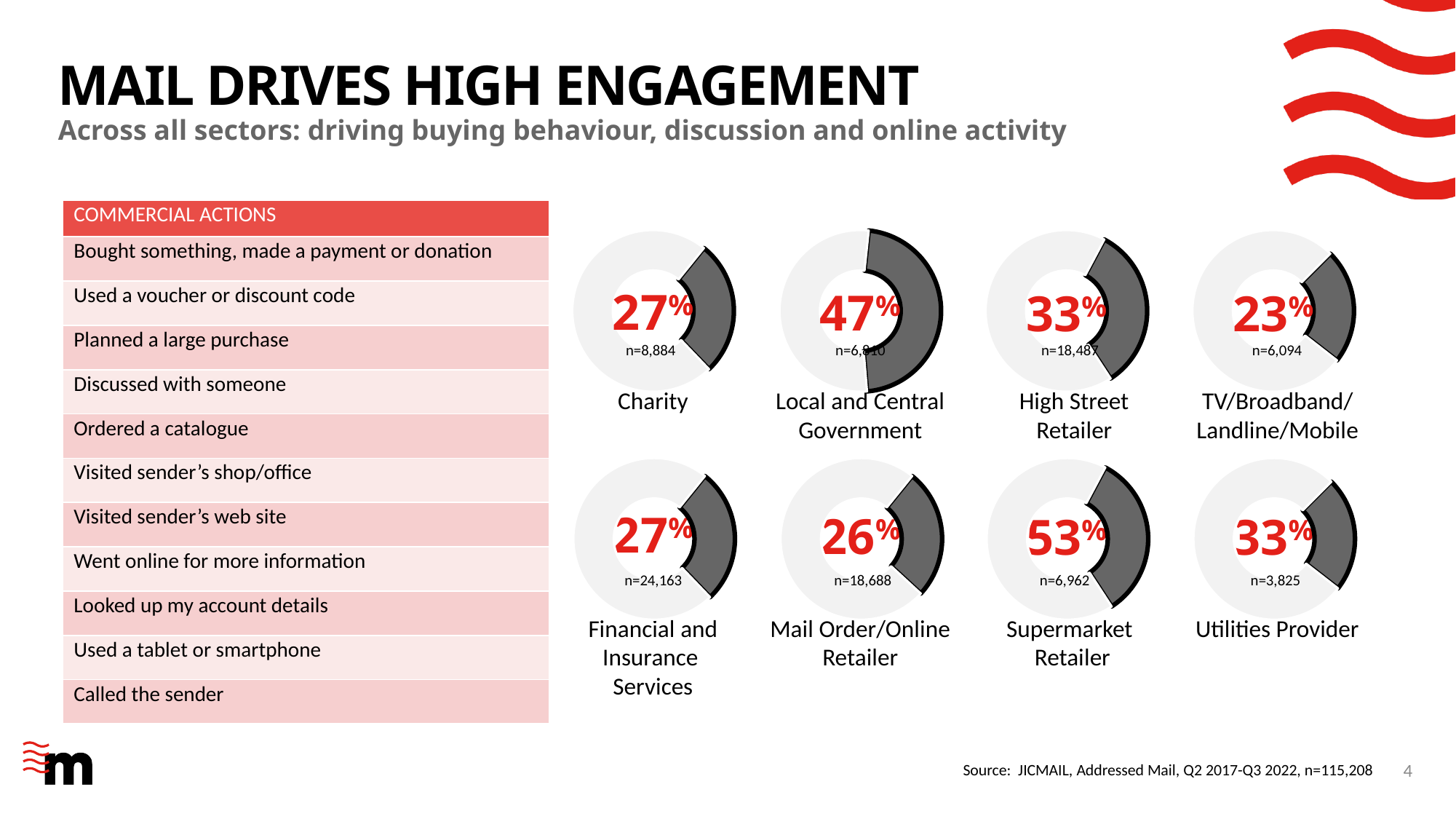
What percentage is shown in the Supermarket Retailer donut chart? 53% How many donut charts are shown on the slide? 8 Which sector's donut chart shows the highest percentage? Supermarket Retailer What is the sample size (n) shown in the Utilities Provider donut chart? n=3,825 Which shows a higher percentage: the Mail Order/Online Retailer chart or the High Street Retailer chart? High Street Retailer What percentage is shown in the Charity donut chart? 27% What is the difference in percentage points between the Supermarket Retailer chart and the Local and Central Government chart? 6 Which sector's donut chart shows the lowest percentage? TV/Broadband/Landline/Mobile What percentage is shown in the TV/Broadband/Landline/Mobile donut chart? 23% What is the heading of the red table on the left of the slide? COMMERCIAL ACTIONS What is the sample size (n) shown in the Financial and Insurance Services donut chart? n=24,163 What type of chart is used to show the percentage for each sector? Donut chart